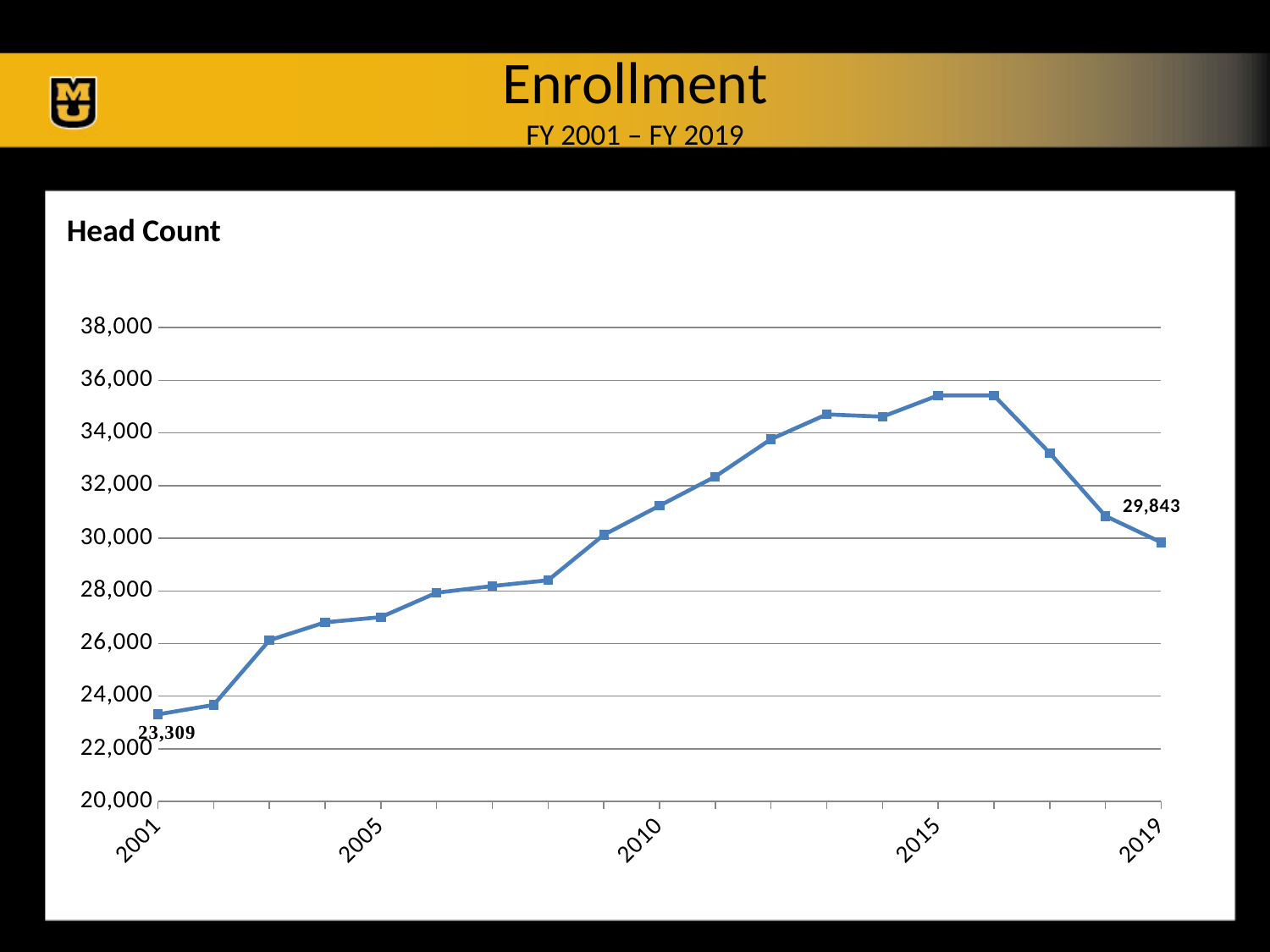
Does the head count rise or fall between 2016 and 2019? Fall Is the head count for 2015 greater or less than 34,000? greater What is the difference between the head count in 2019 and the head count in 2001? 6,534 What kind of chart is used to show the head count? Line chart Which year has the larger head count, 2001 or 2019? 2019 Which year has the lowest head count on the chart? 2001 Is the head count for 2010 greater or less than 30,000? greater What is the head count value shown for 2001? 23,309 What is the head count value shown for 2019? 29,843 What is the title of the chart? Head Count Is the head count for 2005 greater or less than 28,000? less How many data points are plotted on the head count line? 19